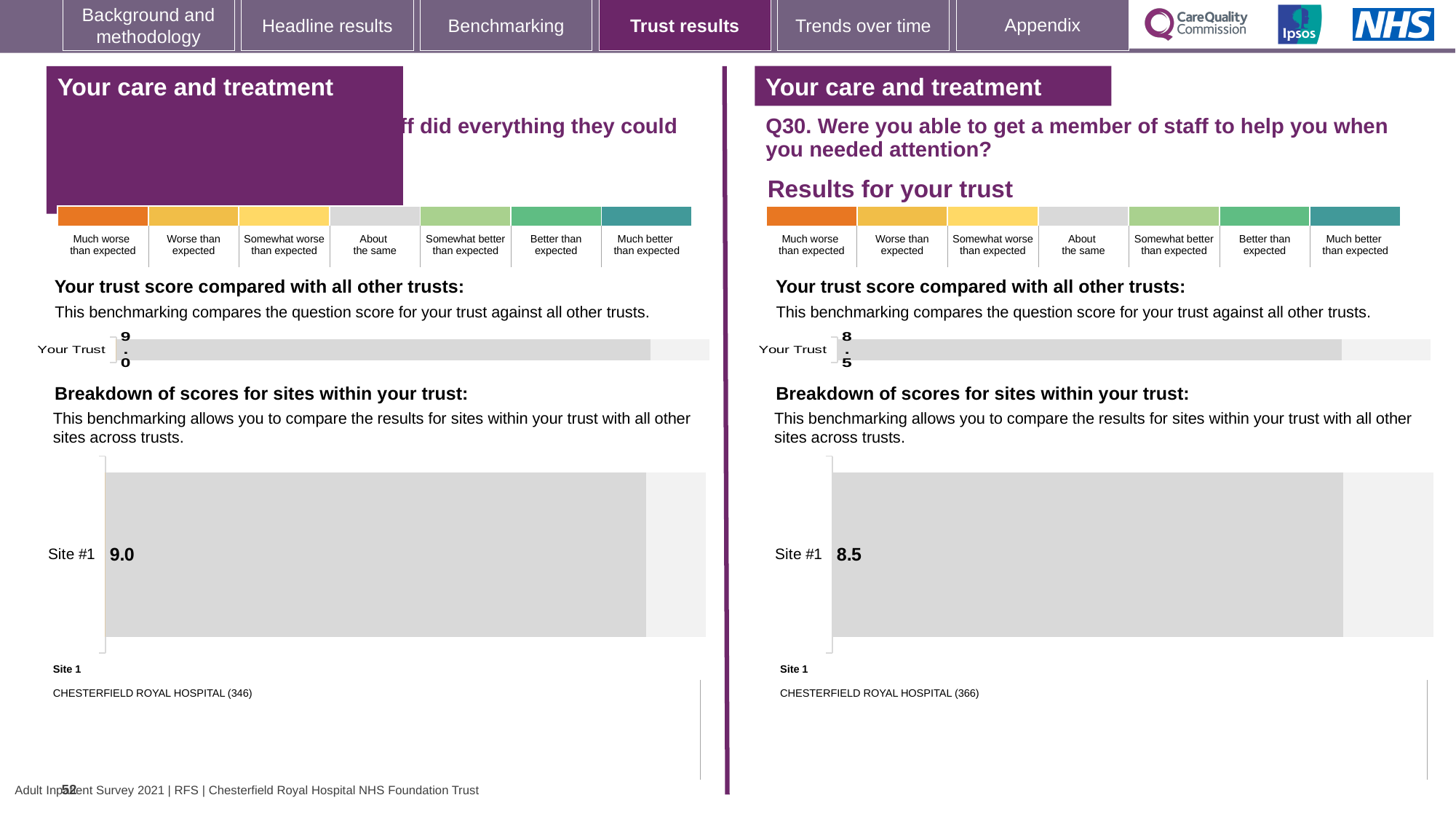
What kind of chart is used to show the Site #1 score on the right panel (Q30)? bar chart On the left panel, what number is shown in brackets after CHESTERFIELD ROYAL HOSPITAL for Site 1? 346 On the right panel (Q30), what is the score shown for Site #1 in the breakdown of scores for sites? 8.5 On the left panel, what is the score shown for Site #1 in the breakdown of scores for sites? 9.0 How many sites are shown in the breakdown of scores for sites on the right panel (Q30)? 1 On the right panel (Q30), what is the score shown for Your Trust? 8.5 Which panel shows the higher Site #1 score, the left panel or the right panel (Q30)? left panel How many sites are shown in the breakdown of scores for sites on the left panel? 1 On the left panel, what is the score shown for Your Trust? 9.0 What is the difference between the Site #1 score on the left panel and the Site #1 score on the right panel (Q30)? 0.5 On the right panel (Q30), which hospital is listed as Site 1? CHESTERFIELD ROYAL HOSPITAL